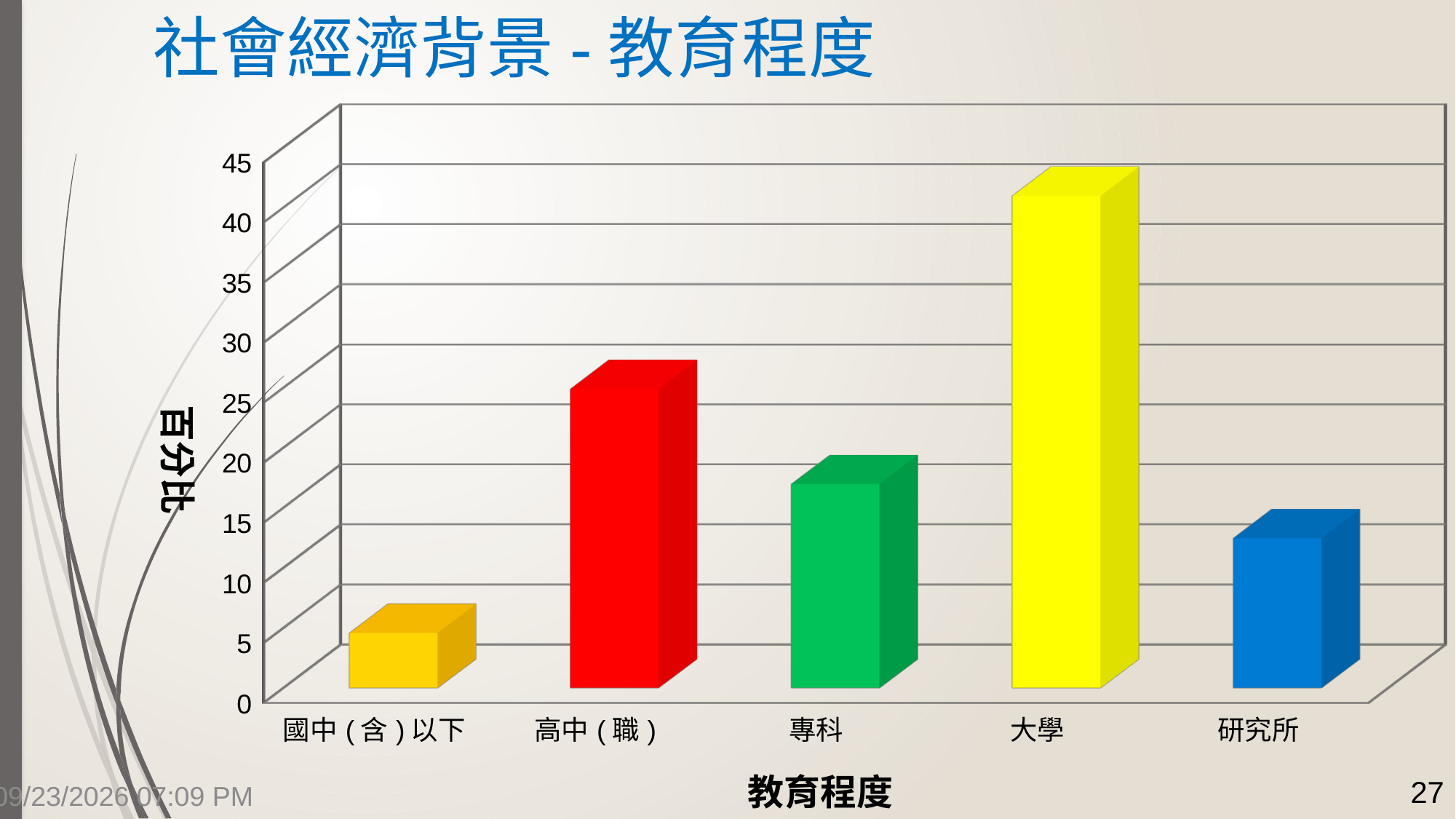
What is the title of the vertical axis? 百分比 Is the value for 研究所 greater or less than 15? less What kind of chart is shown on the slide? bar chart How many education-level categories are shown on the x axis? 5 Which is larger, the value for 研究所 or the value for 專科? 專科 Is the value for 大學 greater or less than 40? greater Is the value for 專科 greater or less than 20? less Which is larger, the value for 高中（職） or the value for 專科? 高中（職） Which education level has the lowest percentage? 國中（含）以下 Which education level has the highest percentage? 大學